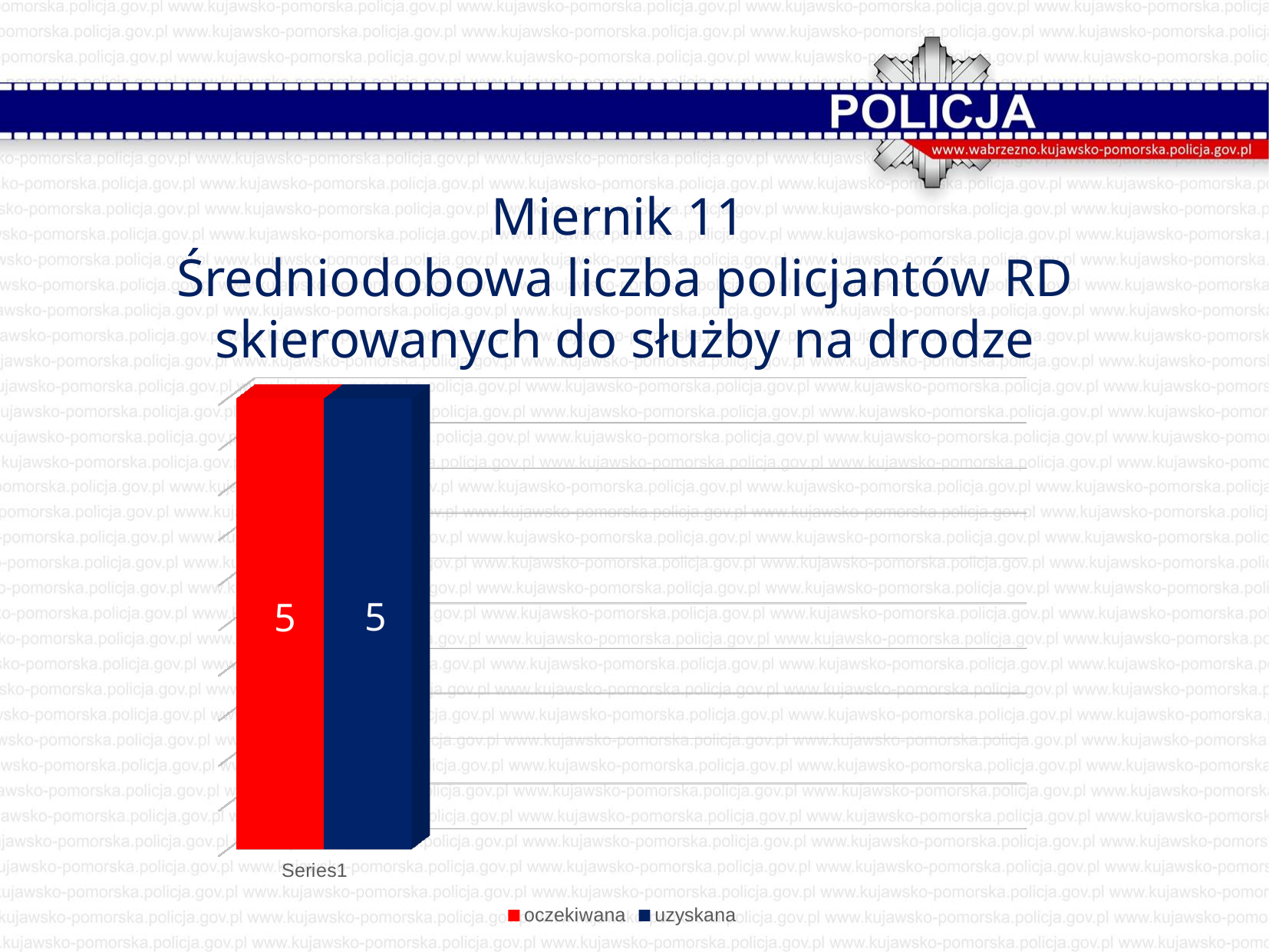
What value is shown for the 'uzyskana' series? 5 How many series does the legend list? 2 What is the category label shown under the bars? Series1 How many bars are plotted in the chart? 2 Which colour represents the 'uzyskana' series in the legend? dark blue Is the value for 'oczekiwana' larger than, smaller than, or equal to the value for 'uzyskana'? equal What is the difference between the 'oczekiwana' and 'uzyskana' values? 0 What value is shown for the 'oczekiwana' series? 5 What is the total of the two bar values shown in the chart? 10 What kind of chart is shown on the slide? bar chart